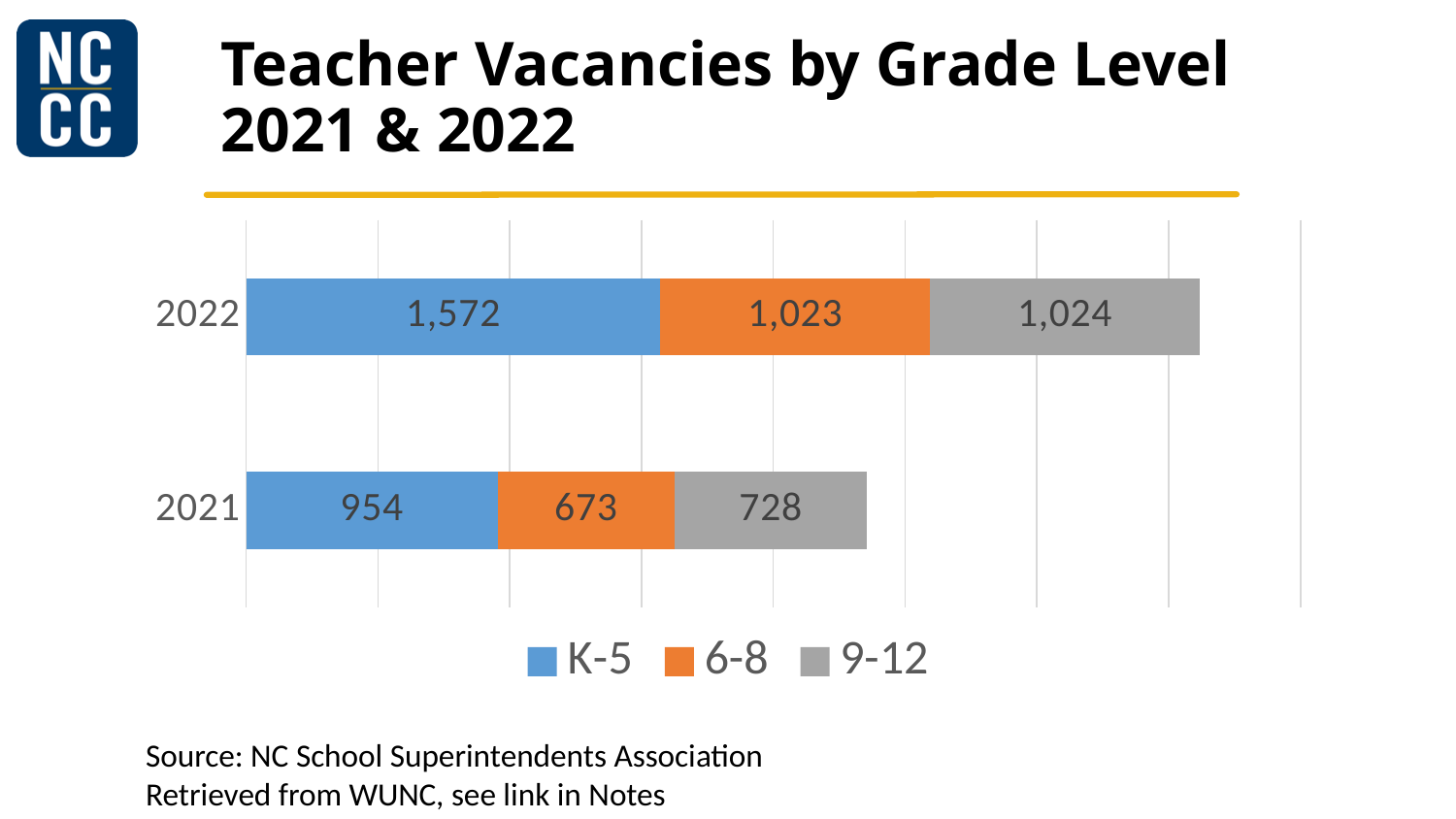
How many years (categories) are plotted on the chart? 2 What kind of chart is shown on the slide? Stacked bar chart Which colour represents the 9-12 series in the chart? Gray Which grade level had the fewest vacancies in 2021? 6-8 What is the total number of teacher vacancies in 2021 across all grade levels? 2,355 Which grade level had the most vacancies in 2021? K-5 What is the number of 9-12 teacher vacancies in 2022? 1,024 By how much did K-5 vacancies increase from 2021 to 2022? 618 How many series does the legend list? 3 What is the number of 6-8 teacher vacancies in 2021? 673 What is the total number of teacher vacancies in 2022 across all grade levels? 3,619 What is the number of K-5 teacher vacancies in 2022? 1,572